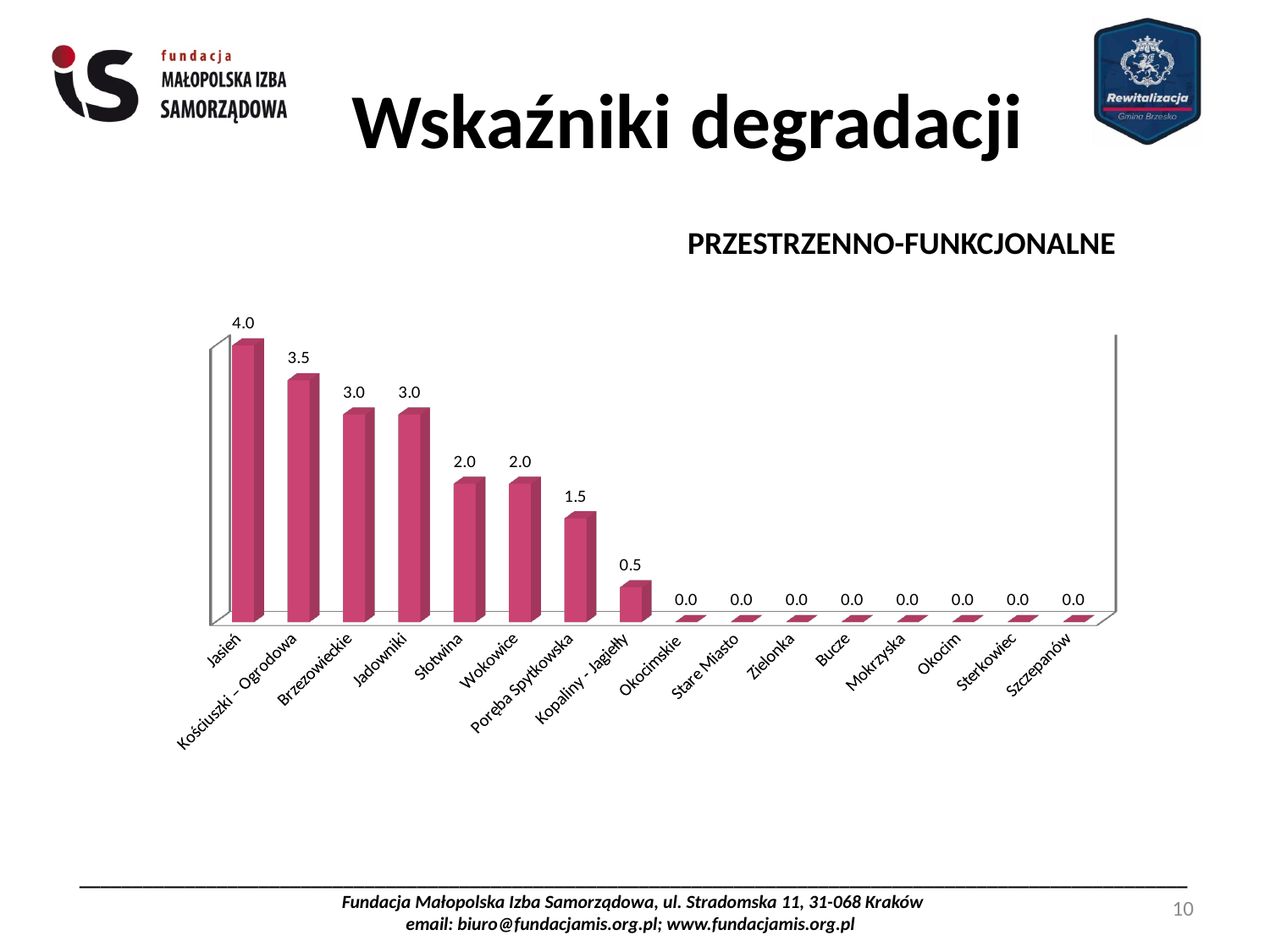
Do the values rise or fall from left to right along the x axis? Fall What is the value for Kopaliny - Jagiełły? 0.5 What is the value for Jasień? 4.0 What is the value for Poręba Spytkowska? 1.5 What is the difference between the values for Brzezowieckie and Wokowice? 1.0 Which is larger, the value for Jadowniki or the value for Poręba Spytkowska? Jadowniki What is the value for Kościuszki – Ogrodowa? 3.5 What is the difference between the values for Jasień and Kościuszki – Ogrodowa? 0.5 What kind of chart is shown on the slide? Bar chart How many categories are shown on the x axis? 16 Which category has the highest value? Jasień What is the value for Słotwina? 2.0